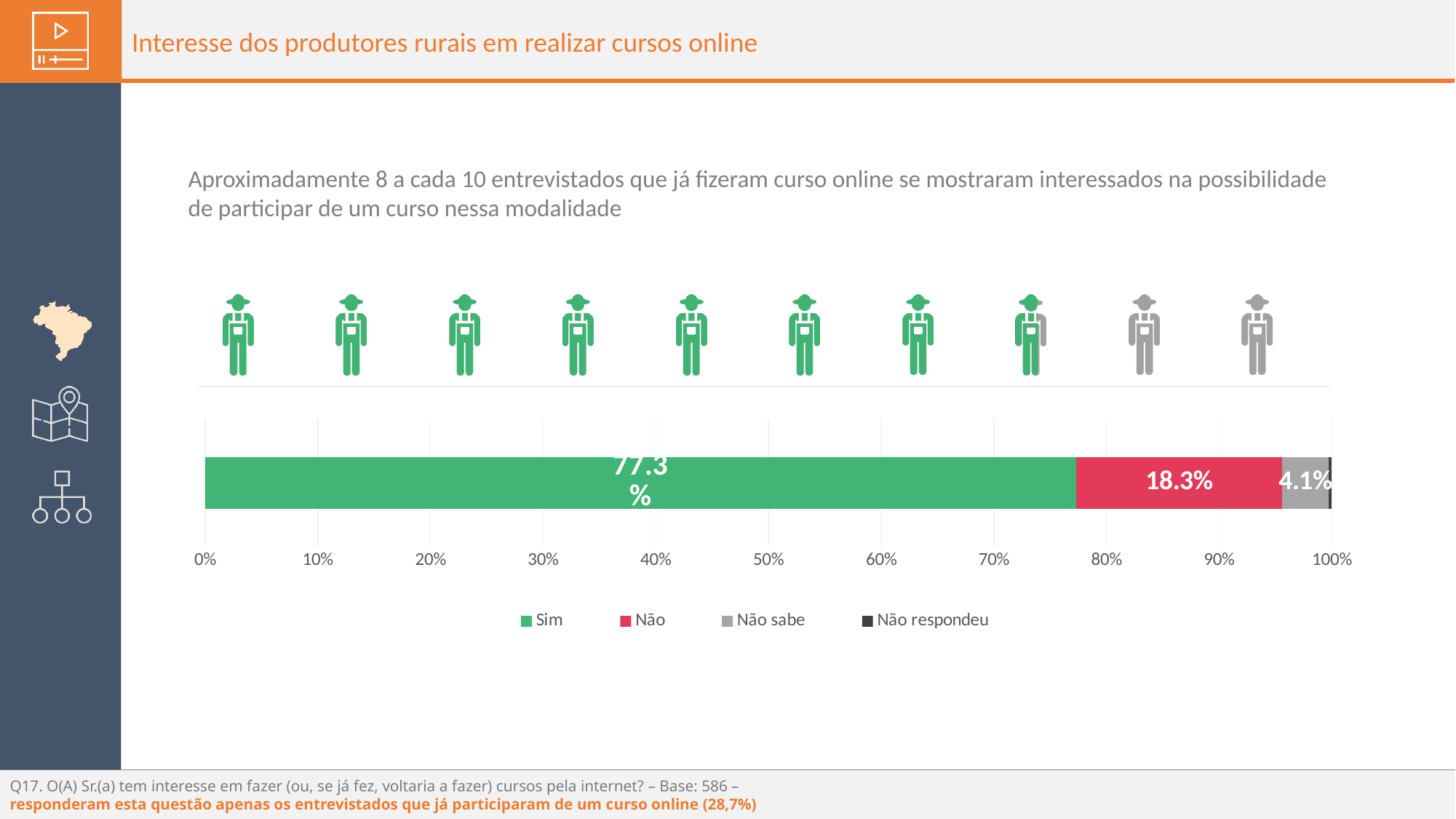
Which response category has the largest share in the bar? Sim How many series does the legend list? 4 What is the difference in percentage points between "Sim" and "Não"? 59.0% Which response category has the smallest share in the bar? Não respondeu What is the value shown for "Não sabe"? 4.1% What kind of chart is shown on the slide? Stacked bar chart What percentage of respondents answered "Sim" in the bar chart? 77.3% What percentage of respondents answered "Não"? 18.3% What colour represents "Sim" in the chart? Green What is the highest value shown on the horizontal axis? 100% Which is larger, the share for "Não" or the share for "Não sabe"? Não Is the value for "Sim" greater or less than 70%? greater